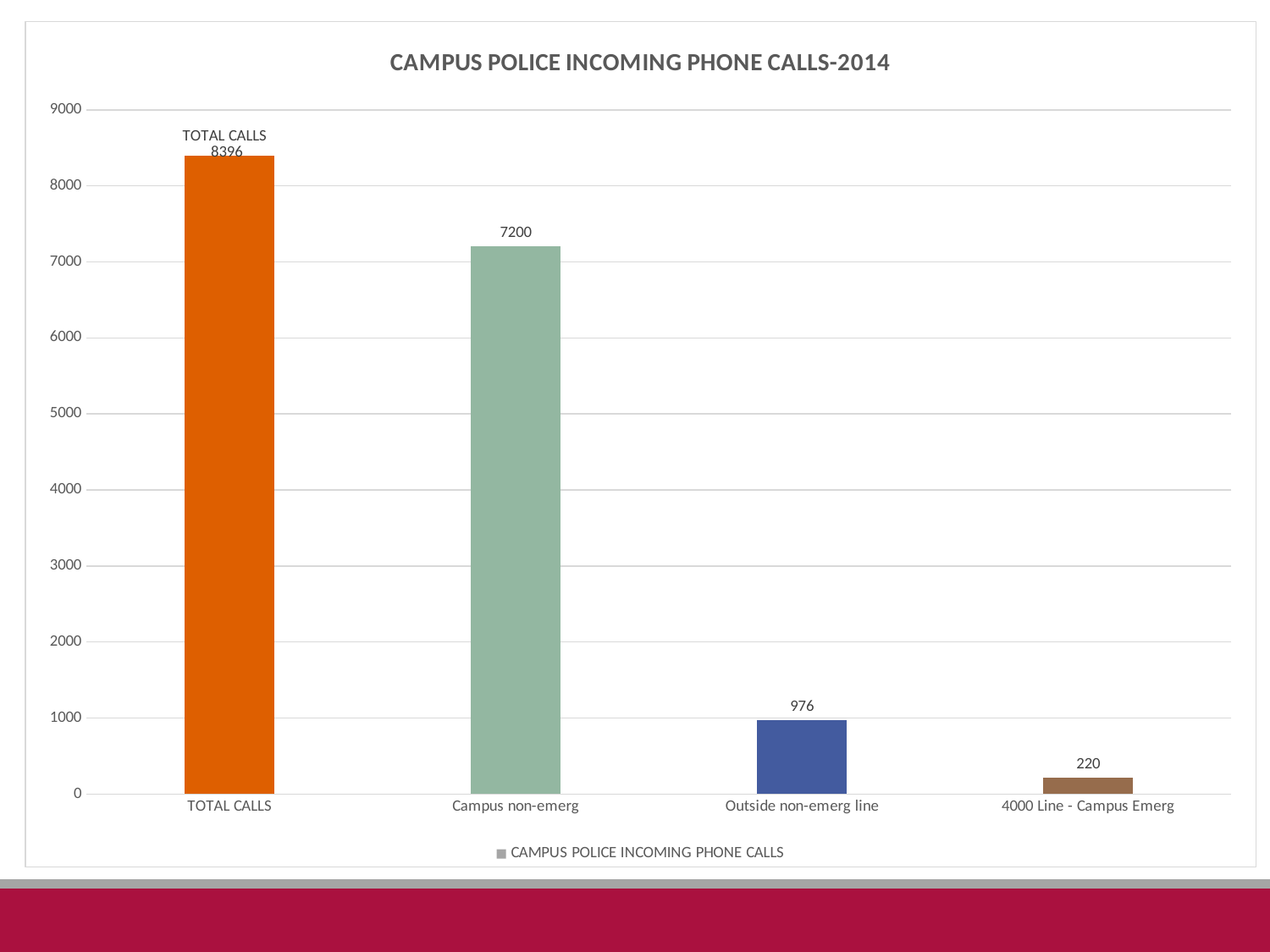
What is the title of the chart? CAMPUS POLICE INCOMING PHONE CALLS-2014 Which is larger, Outside non-emerg line or 4000 Line - Campus Emerg? Outside non-emerg line What is the value for 4000 Line - Campus Emerg? 220 Is the value for Outside non-emerg line greater or less than 1000? less What is the value for TOTAL CALLS? 8396 Which category has the lowest value? 4000 Line - Campus Emerg How many categories are shown on the x axis? 4 What kind of chart is this? bar chart What is the difference between Campus non-emerg and Outside non-emerg line? 6224 What is the value for Outside non-emerg line? 976 Which category has the highest value? TOTAL CALLS What is the value for Campus non-emerg? 7200